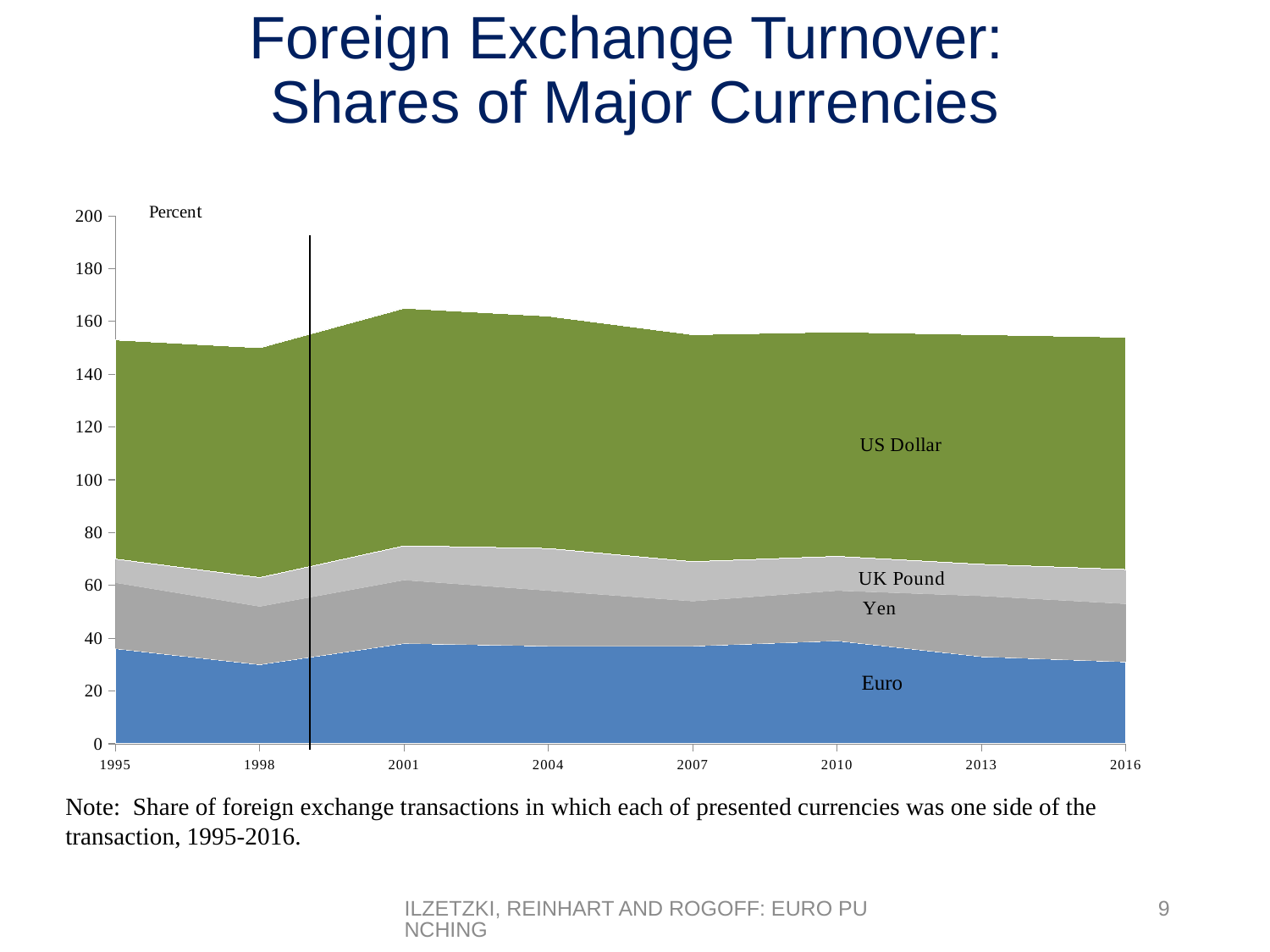
Does the Euro's share rise or fall between 2010 and 2016? fall Is the Euro's share in 1998 greater or less than 40? less What kind of chart is shown on the slide? Stacked area chart Which currency has the largest share of foreign exchange turnover throughout the period? US Dollar What unit is shown on the y axis of the chart? Percent Which currency has the smallest share of foreign exchange turnover in the chart? UK Pound How many currencies are shown as separate areas in the chart? 4 What colour is the US Dollar area in the chart? Green How many years are labelled on the x axis of the chart? 8 Is the combined total of all four currencies in 2001 greater or less than 160? greater Which currency has a larger share, the US Dollar or the Euro? US Dollar Is the combined total of all four currencies in 1998 greater or less than 160? less